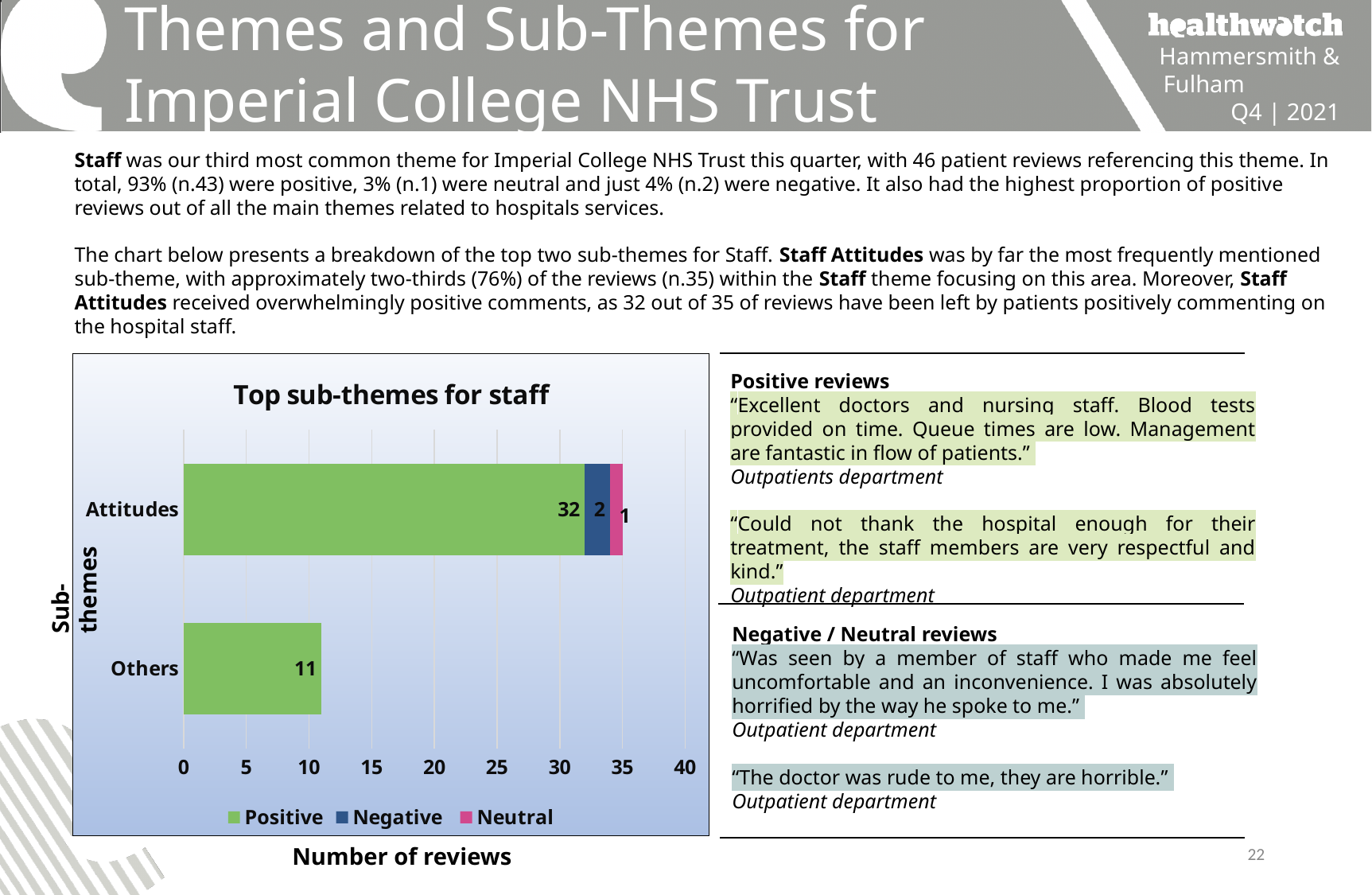
How many series does the chart legend list? 3 What is the number of Negative reviews for Attitudes? 2 What is the number of Positive reviews for Attitudes? 32 What is the number of Positive reviews for Others? 11 What is the label of the horizontal axis? Number of reviews What is the total number of reviews in the Attitudes bar? 35 Which sub-theme has the higher number of Positive reviews, Attitudes or Others? Attitudes How many sub-theme categories are shown in the chart? 2 What is the title of the chart? Top sub-themes for staff What is the number of Neutral reviews for Attitudes? 1 What type of chart is shown on the slide? Stacked bar chart What is the difference between the Positive reviews for Attitudes and for Others? 21